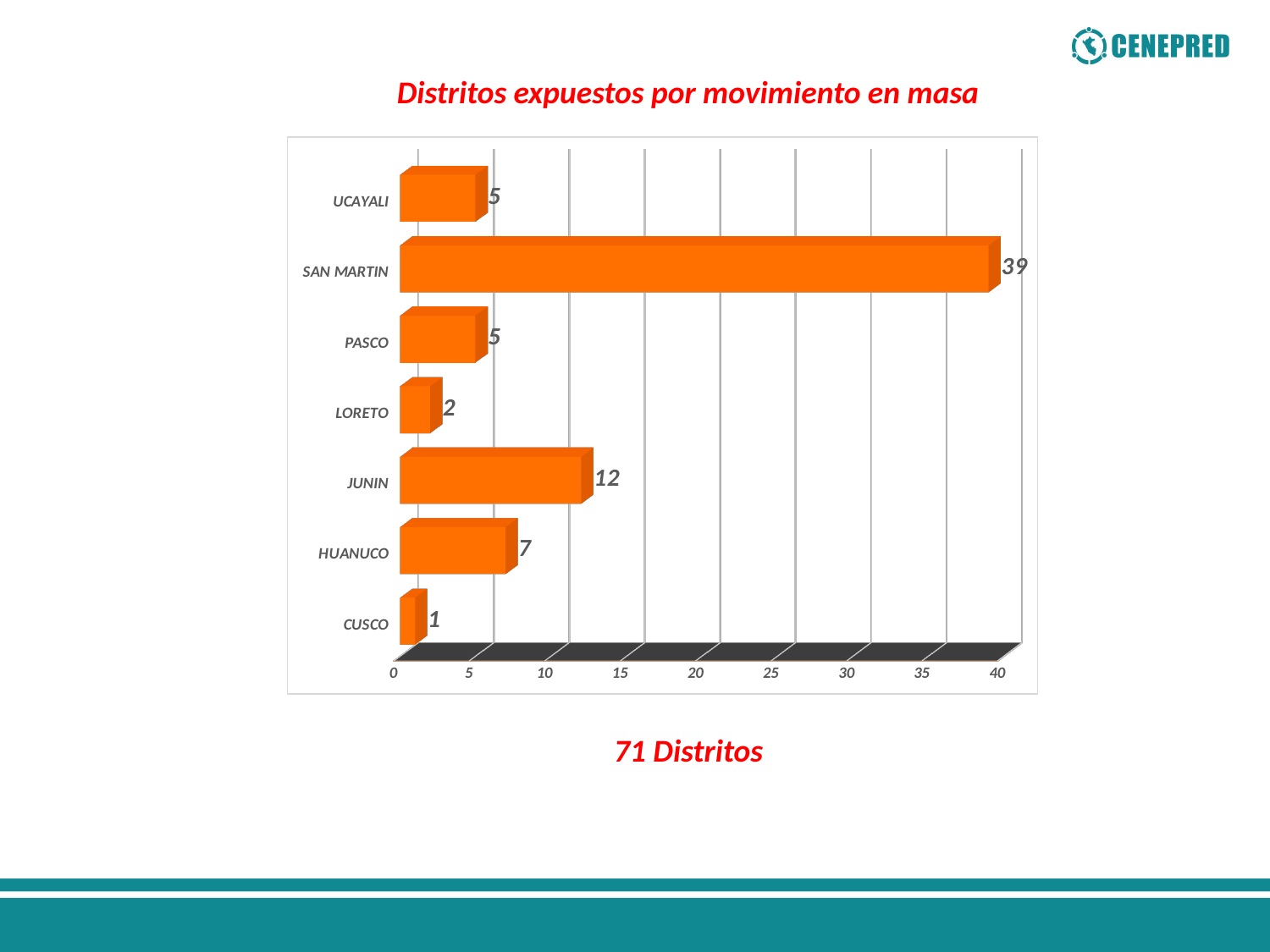
How many categories are shown in the chart? 7 Which is larger, the value for HUANUCO or the value for PASCO? HUANUCO What is the difference between the values for SAN MARTIN and JUNIN? 27 What kind of chart is shown on the slide? bar chart What is the value for SAN MARTIN? 39 What is the title of the chart? Distritos expuestos por movimiento en masa What is the value for HUANUCO? 7 Is the value for JUNIN greater or less than 10? greater What is the value for JUNIN? 12 Which category has the lowest value? CUSCO What is the value for LORETO? 2 Which category has the highest value? SAN MARTIN